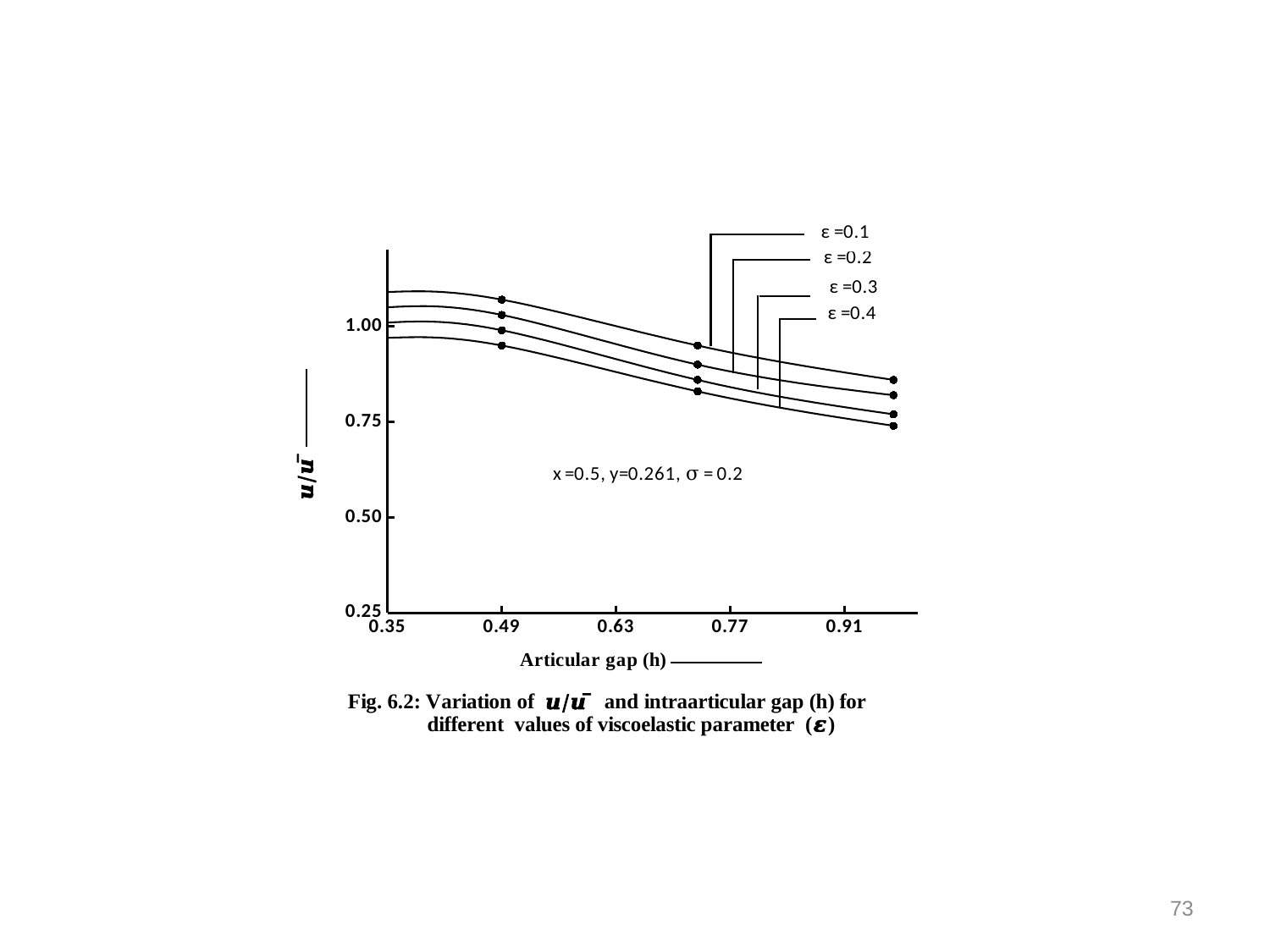
At h = 0.49, which curve has the larger value, ε =0.2 or ε =0.3? ε =0.2 As the articular gap (h) increases, do the values of u/ū rise or fall? fall How many marked data points are there on each curve? 3 Which curve lies highest on the chart? ε =0.1 What is the label of the x axis? Articular gap (h) How many curves (values of ε) are plotted on the chart? 4 What kind of chart is shown on the slide? line chart At h = 0.49, is the value for the ε =0.4 curve greater or less than 1.00? less At the rightmost marked point, is the value for the ε =0.1 curve greater or less than 0.75? greater What parameter values are stated in the annotation inside the plot area? x =0.5, y=0.261, σ = 0.2 Which curve lies lowest on the chart? ε =0.4 At h = 0.49, is the value for the ε =0.1 curve greater or less than 1.00? greater